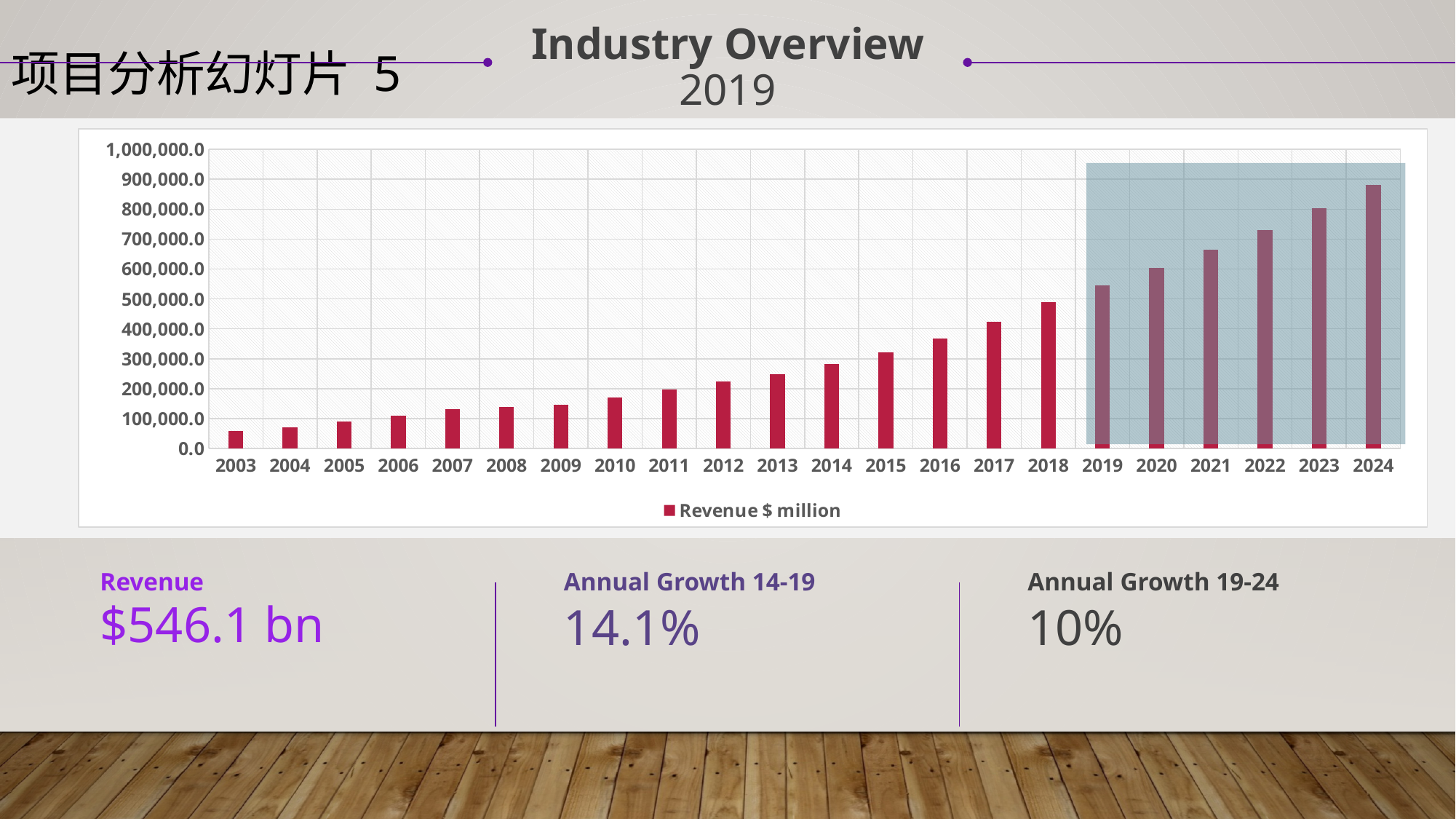
Which year has the lowest revenue bar? 2003 What kind of chart is shown on the slide? bar chart Is the value for 2024 greater or less than 800,000.0? greater Which year has the highest revenue bar? 2024 What is the legend entry for the series? Revenue $ million Do the revenue values rise or fall from 2003 to 2024? rise How many years are shown on the x axis? 22 Which year has the larger revenue, 2010 or 2020? 2020 How many series does the legend list? 1 Is the value for 2021 greater or less than 600,000.0? greater Is the value for 2003 greater or less than 100,000.0? less